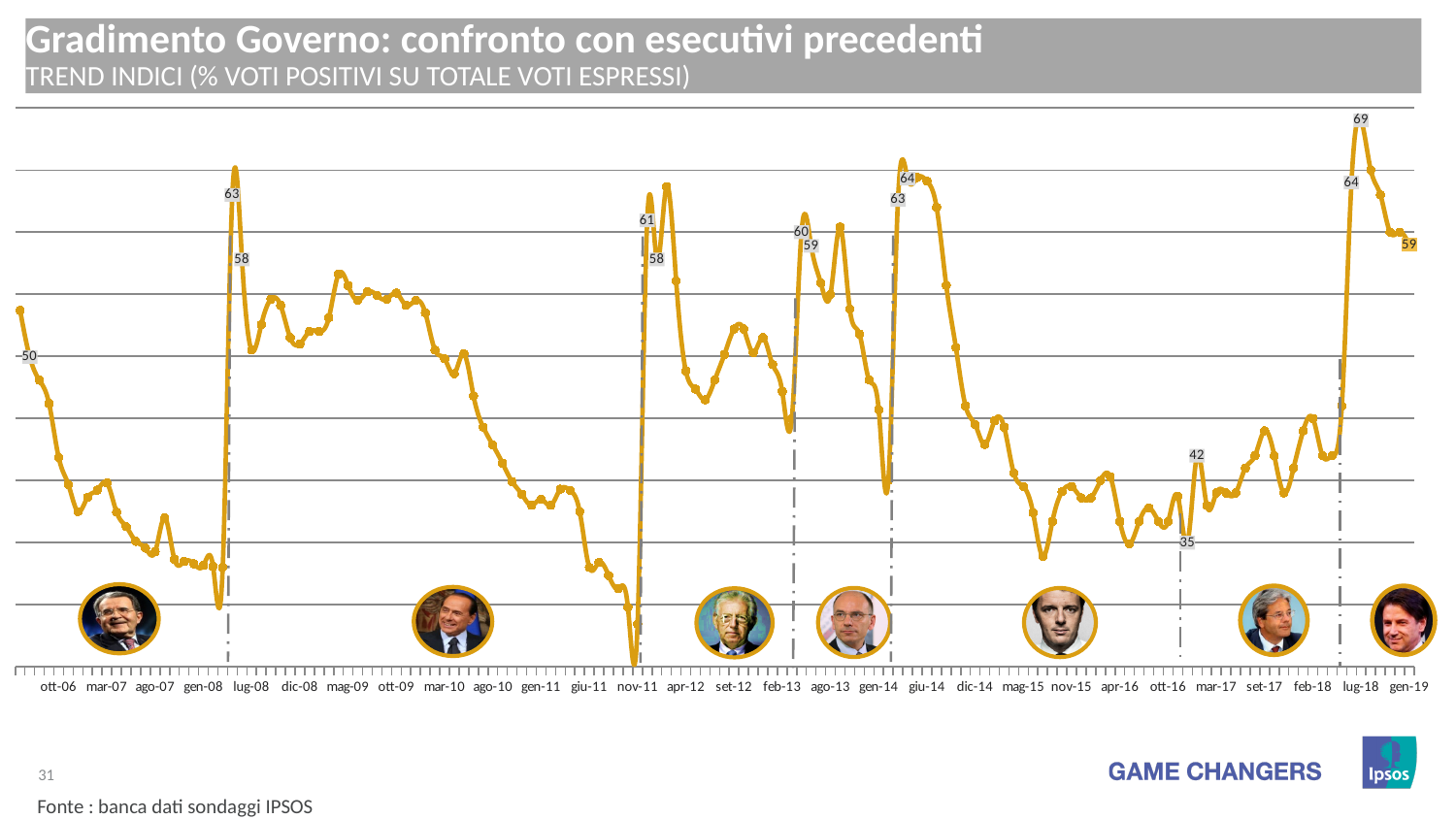
What is the highest labelled value on the line? 69 Does the line rise or fall between ott-06 and gen-08? fall What is the difference between the peak labelled 69 and the final value labelled 59? 10 What is the difference between the labelled values 42 and 35 in the ott-16 to mar-17 period? 7 What kind of chart is shown on the slide? line chart What is the title of the chart? Gradimento Governo: confronto con esecutivi precedenti Which is larger: the peak labelled near lug-08 (63) or the peak labelled near giu-14 (64)? 64 (near giu-14) Does the line rise or fall between the peak at lug-18 and gen-19? fall What is the lowest labelled value on the line? 35 What value is labelled at the end of the line, at gen-19? 59 What source is cited at the bottom of the slide? Fonte : banca dati sondaggi IPSOS